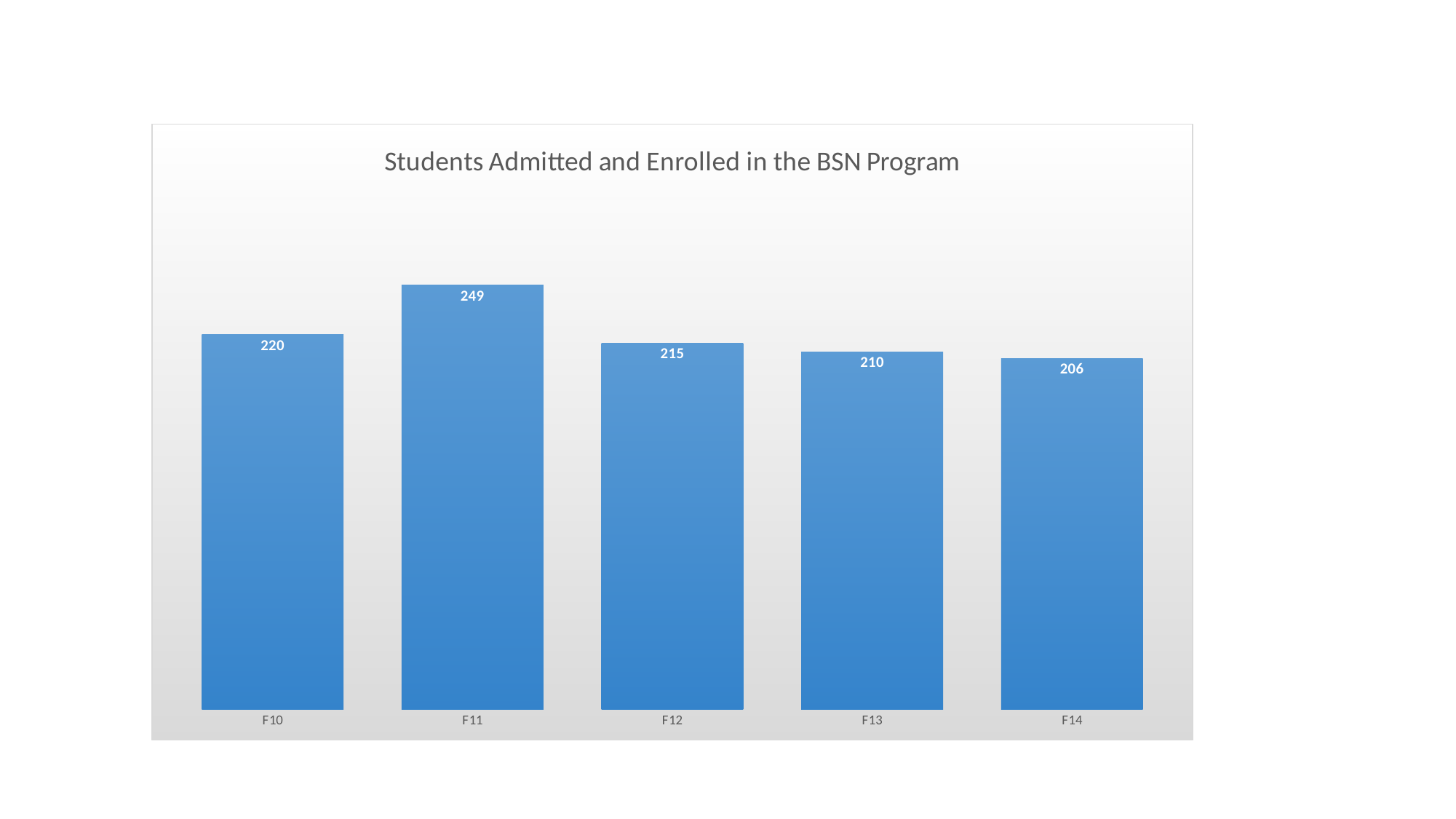
Do the values rise or fall from F11 to F14? fall What is the difference between the values for F11 and F10? 29 What is the value for F11? 249 What is the difference between the values for F12 and F13? 5 Which category has the highest value? F11 What is the title of the chart? Students Admitted and Enrolled in the BSN Program What is the value for F14? 206 Which category has the lowest value? F14 How many categories are shown on the x axis? 5 What kind of chart is shown? bar chart Which is larger, the value for F10 or the value for F13? F10 What is the value for F12? 215